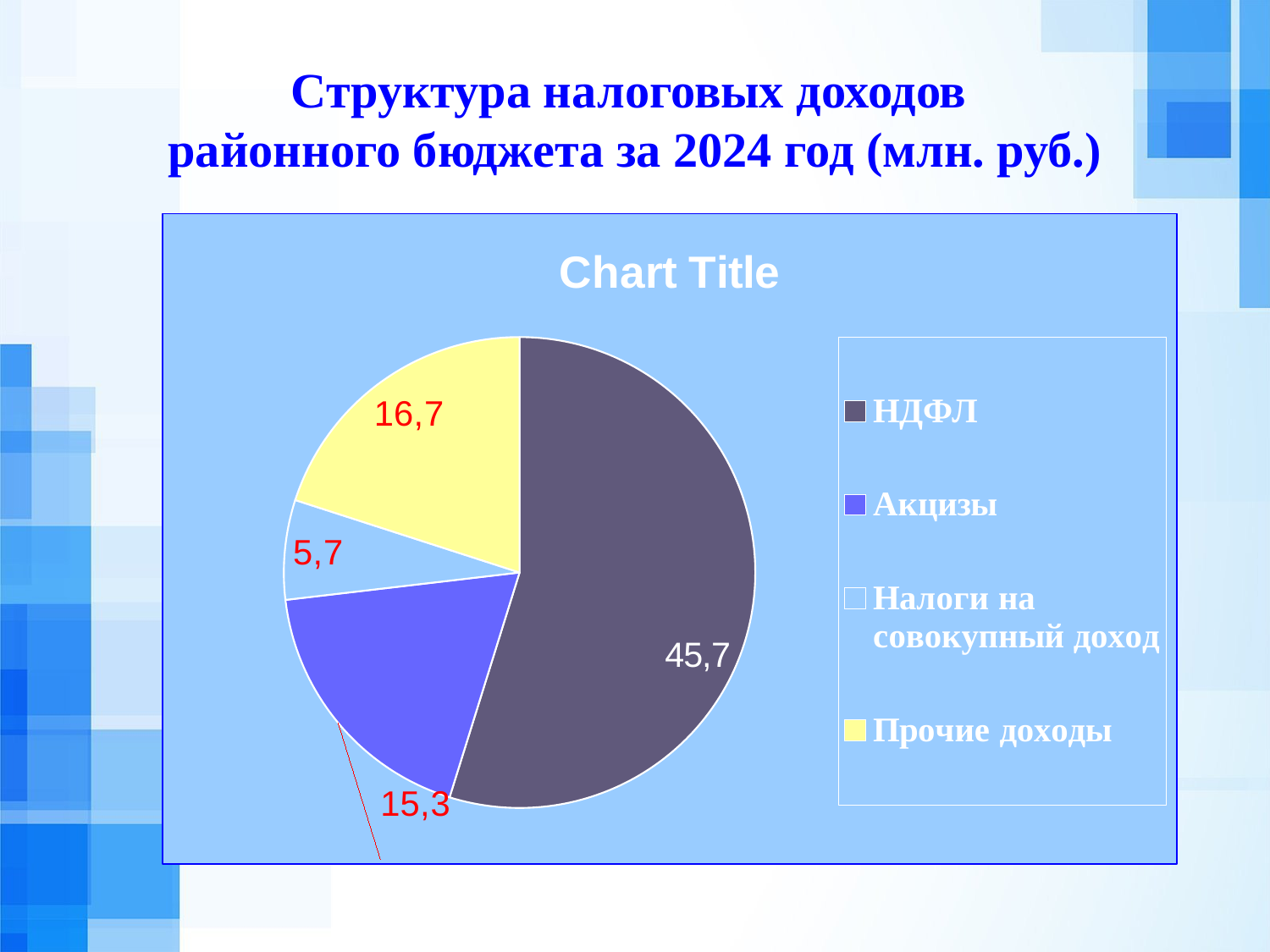
Which category has the smallest slice of the pie? Налоги на совокупный доход What is the value for НДФЛ? 45,7 How many categories does the pie chart have? 4 What is the value for Прочие доходы? 16,7 Which category has the largest slice of the pie? НДФЛ What is the value for Налоги на совокупный доход? 5,7 What is the total of all the slice values in the pie chart? 83,4 What type of chart is shown on the slide? pie chart What is the value for Акцизы? 15,3 What is the difference between the values for НДФЛ and Акцизы? 30,4 Which is larger, the value for Прочие доходы or the value for Акцизы? Прочие доходы What colour is the slice for Прочие доходы? yellow